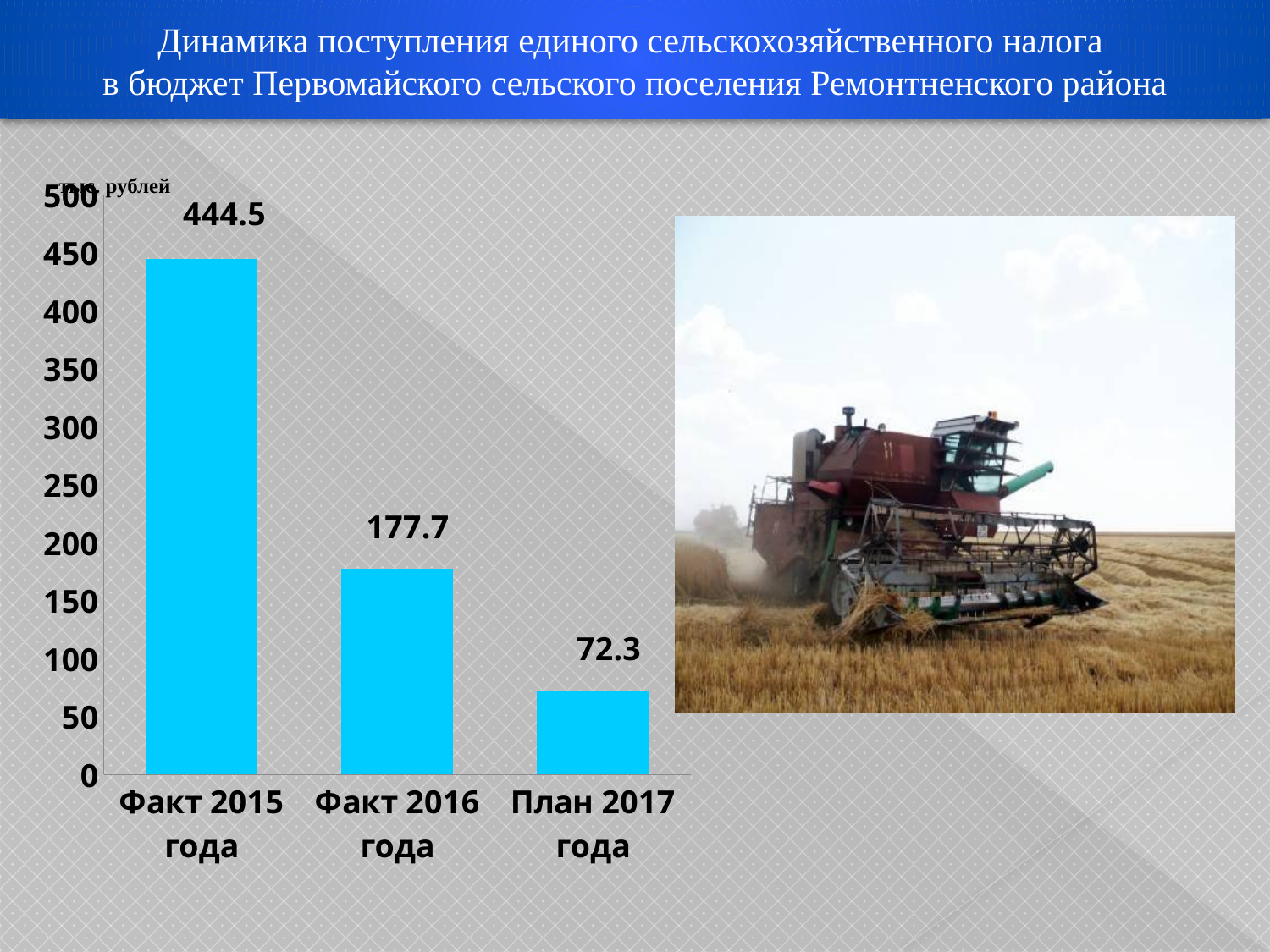
What is the value for Факт 2015 года? 444.5 What is the value for Факт 2016 года? 177.7 Which category has the highest value? Факт 2015 года What is the difference between the values for Факт 2015 года and Факт 2016 года? 266.8 What is the value for План 2017 года? 72.3 How many categories are shown on the x axis? 3 Is the value for Факт 2016 года greater or less than 200? less What kind of chart is shown on the slide? bar chart Which is larger, the value for Факт 2016 года or План 2017 года? Факт 2016 года What is the difference between the values for Факт 2016 года and План 2017 года? 105.4 Do the values rise or fall from Факт 2015 года to План 2017 года? fall Which category has the lowest value? План 2017 года